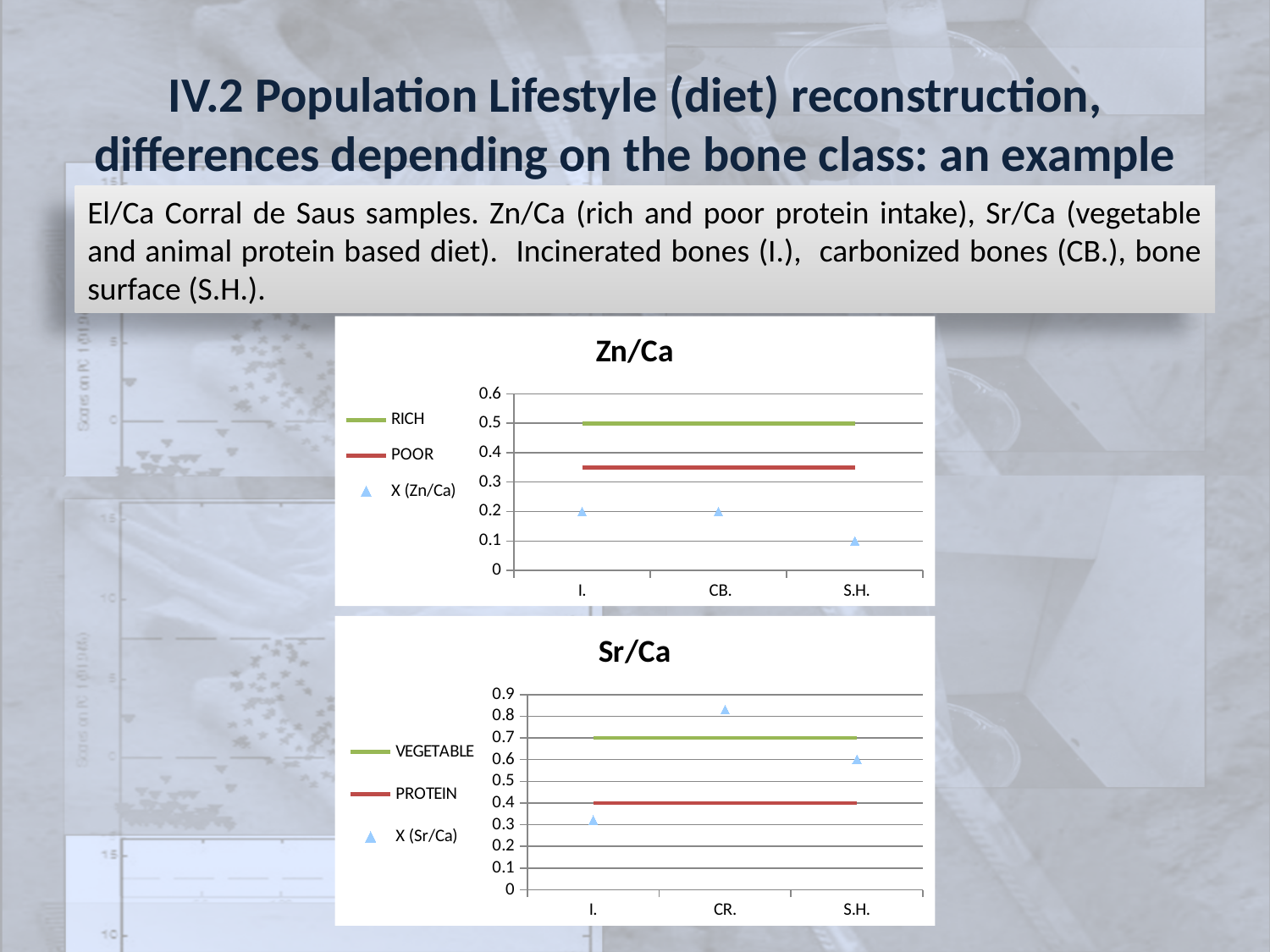
In the Zn/Ca chart, what is the X (Zn/Ca) value for S.H.? 0.1 In the Zn/Ca chart, is the POOR line greater or less than 0.4? less In the Sr/Ca chart, what value does the PROTEIN line sit at? 0.4 In the Zn/Ca chart, what are the three categories on the x axis? I., CB., S.H. In the Zn/Ca chart, how many entries does the legend list? 3 In the Zn/Ca chart, what value does the RICH line sit at? 0.5 In the Sr/Ca chart, is the X (Sr/Ca) point for CR. greater or less than 0.8? greater In the Sr/Ca chart, which is larger, the X (Sr/Ca) point for I. or for S.H.? S.H. In the Zn/Ca chart, is the X (Zn/Ca) point for I. greater or less than 0.3? less In the Zn/Ca chart, which category has the lowest X (Zn/Ca) point? S.H. In the Sr/Ca chart, which category has the highest X (Sr/Ca) point? CR. In the Sr/Ca chart, what value does the VEGETABLE line sit at? 0.7